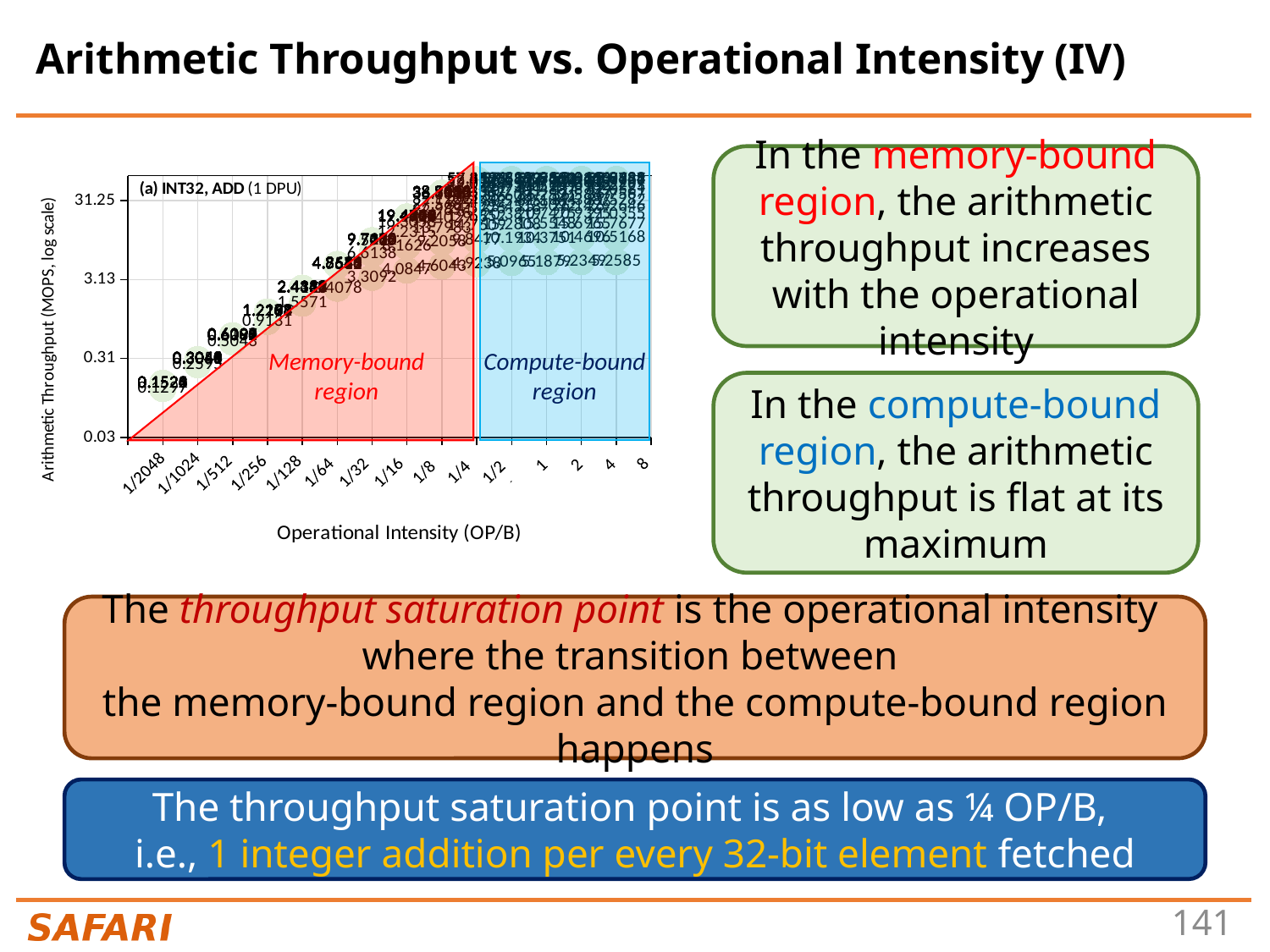
What is the title of the chart's y axis? Arithmetic Throughput (MOPS, log scale) Is the arithmetic throughput at operational intensity 1/16 greater or less than 3.13? greater Is the arithmetic throughput at operational intensity 1/256 greater or less than 0.31? greater In the memory-bound region, does arithmetic throughput rise or fall as operational intensity increases? rise Is the arithmetic throughput at operational intensity 1/2048 greater or less than 0.31? less How many operational intensity values are marked on the x axis of the chart? 15 Which has the higher arithmetic throughput: operational intensity 1/512 or 1/32? 1/32 Which operational intensity has the lowest arithmetic throughput? 1/2048 What kind of chart is shown on the slide? scatter chart In the compute-bound region, does arithmetic throughput rise, fall, or stay flat as operational intensity increases? stay flat What is the label shown inside the chart's plot area at the top left? (a) INT32, ADD (1 DPU)